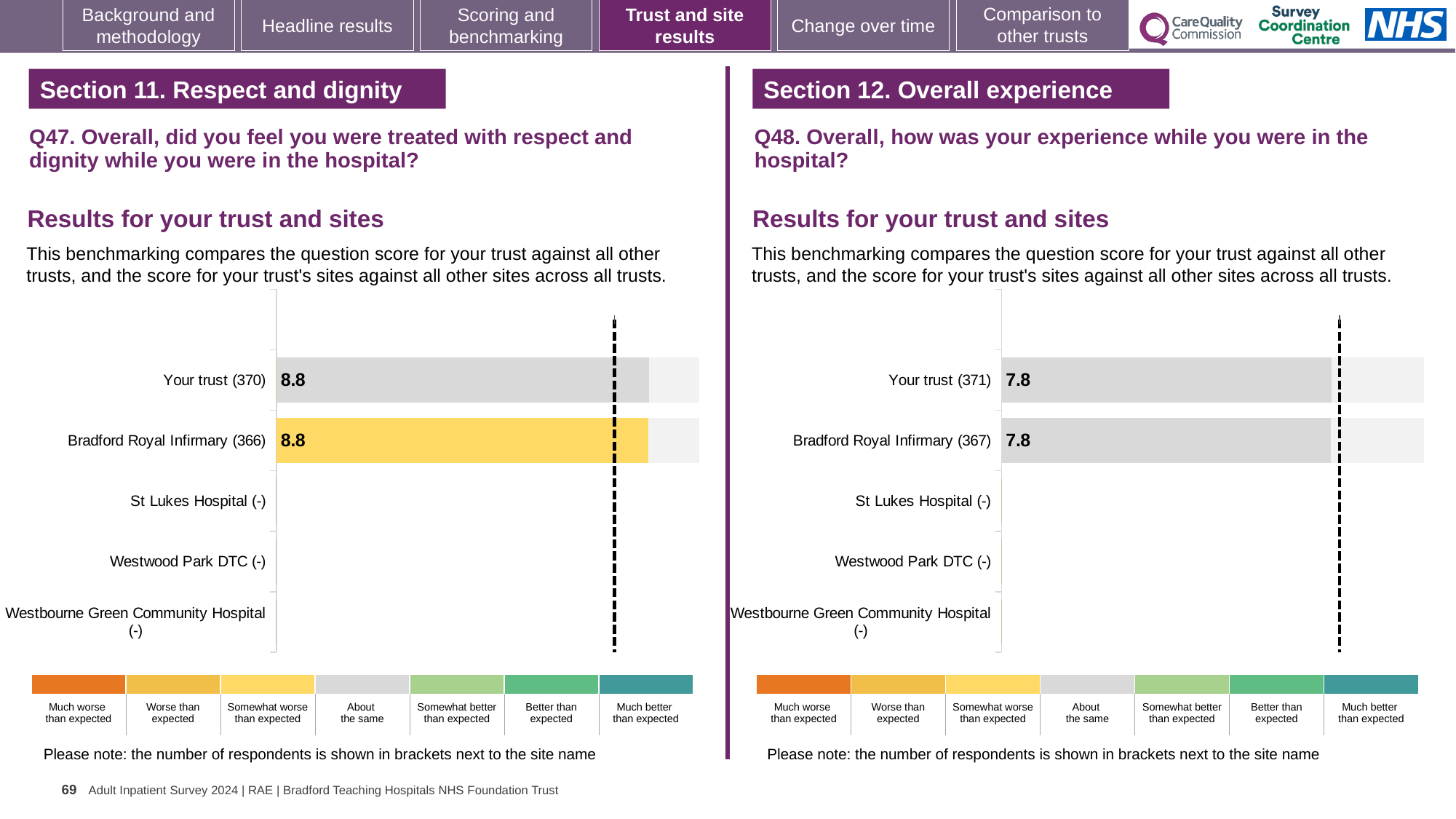
On the Q48 chart (right), how many respondents are shown in brackets for Your trust? 371 On the Q47 chart (left), what is the score for Bradford Royal Infirmary? 8.8 Which is larger: the Your trust score on the Q47 chart (left) or the Your trust score on the Q48 chart (right)? Q47 chart (left) On the Q47 chart (left), which benchmark category does the colour of the Bradford Royal Infirmary bar correspond to in the legend? Somewhat worse than expected On the Q48 chart (right), which benchmark category does the colour of the Bradford Royal Infirmary bar correspond to in the legend? About the same On the Q47 chart (left), how many respondents are shown in brackets for Bradford Royal Infirmary? 366 On the Q48 chart (right), what is the score for Your trust? 7.8 On the Q47 chart (left), what is the score for Your trust? 8.8 On the Q47 chart (left), how many site/trust categories are listed on the vertical axis? 5 On the Q48 chart (right), what is the score for Bradford Royal Infirmary? 7.8 What kind of chart is used on the Q48 chart (right)? Bar chart What is the difference between the Your trust score on the Q47 chart (left) and the Your trust score on the Q48 chart (right)? 1.0